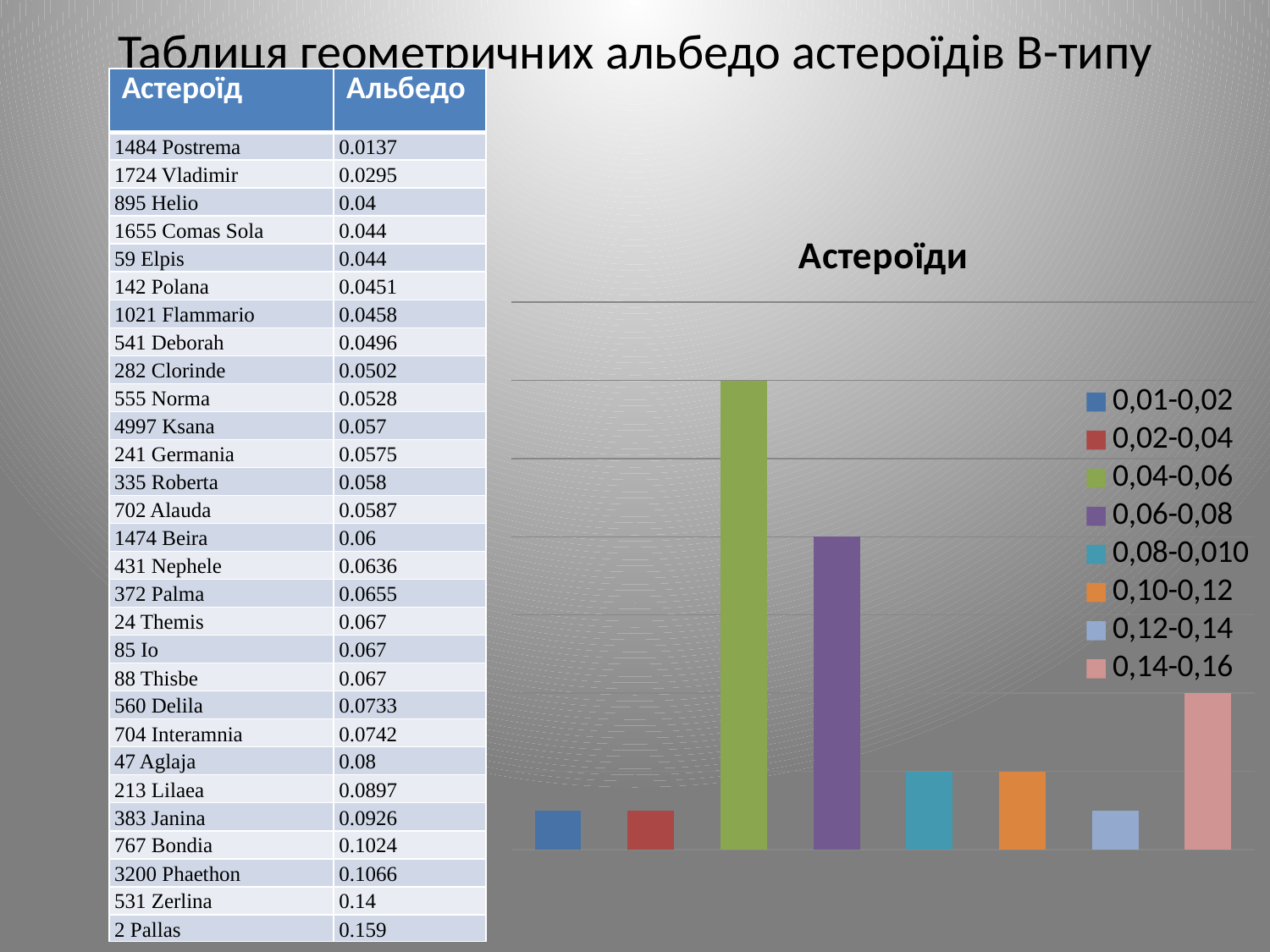
What is the title of the chart? Астероїди Which albedo range has the second tallest bar in the chart? 0,06-0,08 Which bar is taller: 0,06-0,08 or 0,14-0,16? 0,06-0,08 Which bar is taller: 0,08-0,010 or 0,12-0,14? 0,08-0,010 What colour is the tallest bar in the chart? green How many bars does the chart show? 8 Which bar is taller: 0,14-0,16 or 0,10-0,12? 0,14-0,16 What kind of chart is shown on the slide? bar chart Which albedo range has the tallest bar in the chart? 0,04-0,06 How many entries does the chart's legend list? 8